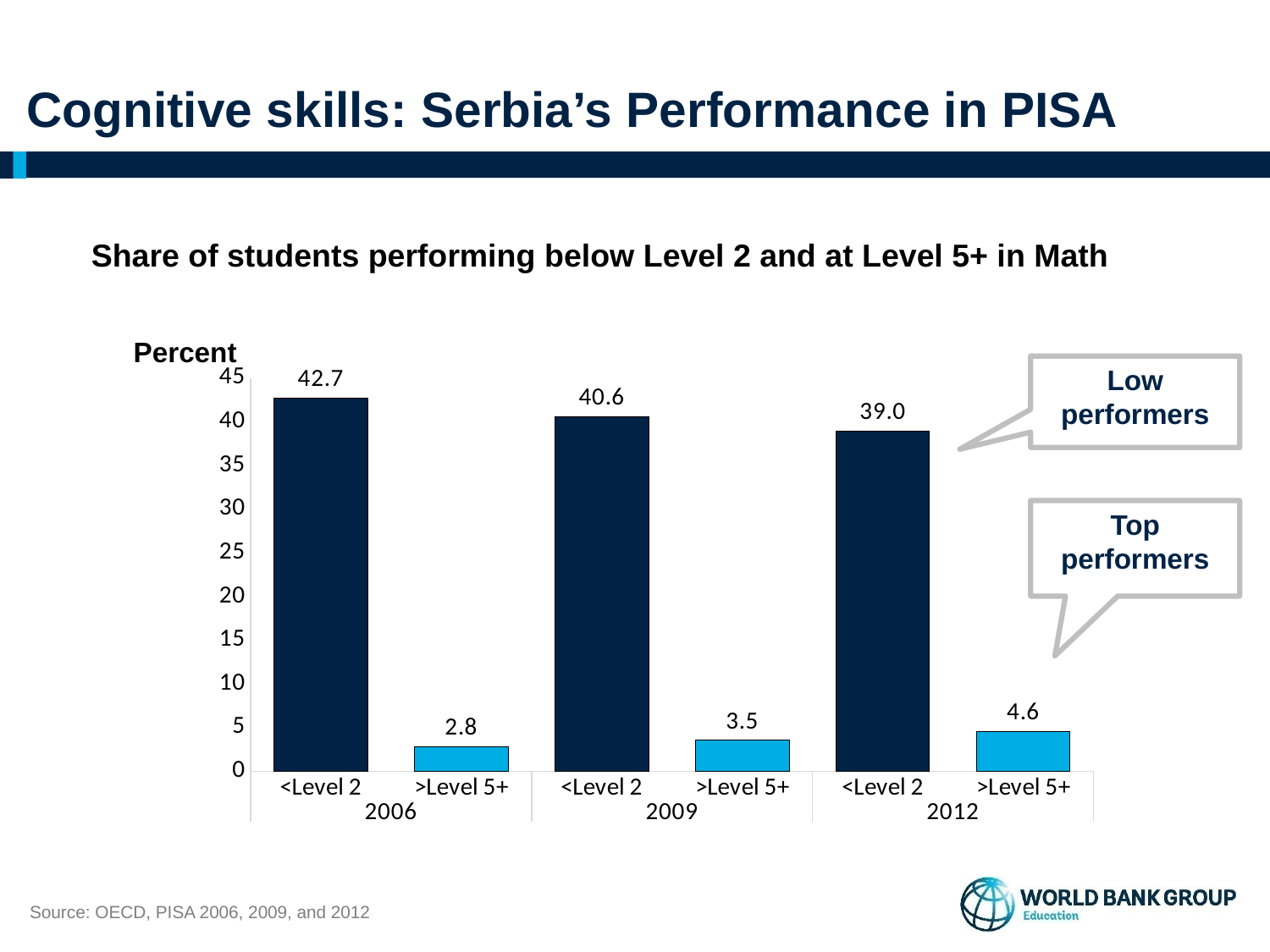
What is the difference between the >Level 5+ share in 2012 and in 2006? 1.8 Which year has the highest share of students below Level 2? 2006 What is the share of students performing below Level 2 in Math in 2006? 42.7 What is the value for >Level 5+ in 2009? 3.5 Does the share of students below Level 2 rise or fall from 2006 to 2012? fall What is the difference between the <Level 2 share in 2006 and in 2012? 3.7 How many bars are plotted in the chart? 6 What is the share of students performing at Level 5+ in Math in 2012? 4.6 What kind of chart is shown on the slide? bar chart Is the value for <Level 2 in 2012 greater or less than 40? less Which year has the lowest share of students at Level 5+? 2006 Which is larger: the <Level 2 share in 2009 or in 2012? 2009